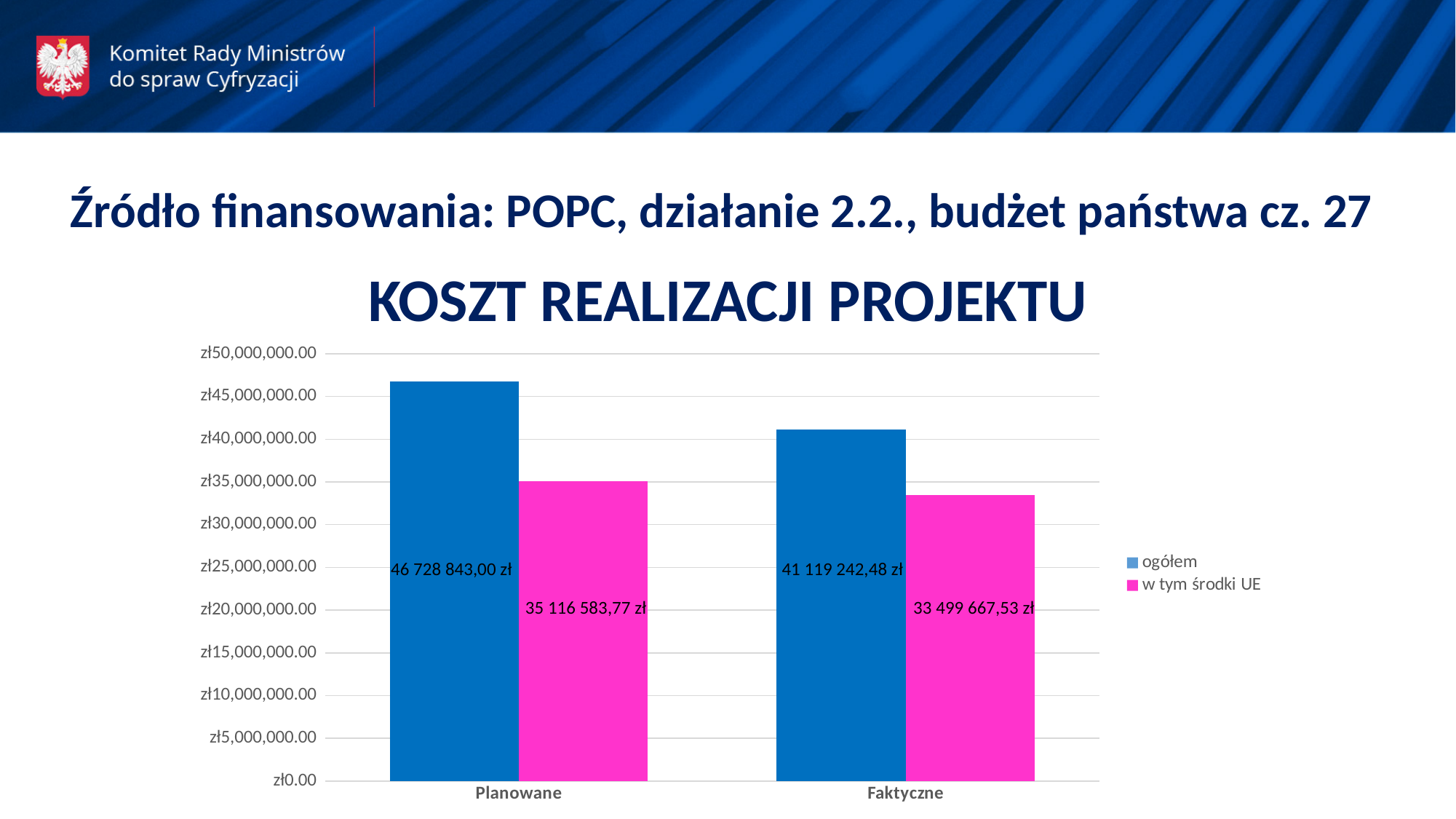
What is the value of the ogółem bar for Faktyczne? 41 119 242,48 zł What is the difference between the ogółem and w tym środki UE values for Faktyczne? 7 619 574,95 zł What is the value of the ogółem bar for Planowane? 46 728 843,00 zł Which is larger: the w tym środki UE value for Planowane or for Faktyczne? Planowane Which bar in the chart has the highest value? ogółem for Planowane Which bar in the chart has the lowest value? w tym środki UE for Faktyczne What type of chart is shown on the slide? bar chart What is the value of the w tym środki UE bar for Faktyczne? 33 499 667,53 zł Is the ogółem value for Planowane greater or less than zł45,000,000.00? greater How many series does the legend list? 2 What is the difference between the ogółem values for Planowane and Faktyczne? 5 609 600,52 zł What is the value of the w tym środki UE bar for Planowane? 35 116 583,77 zł